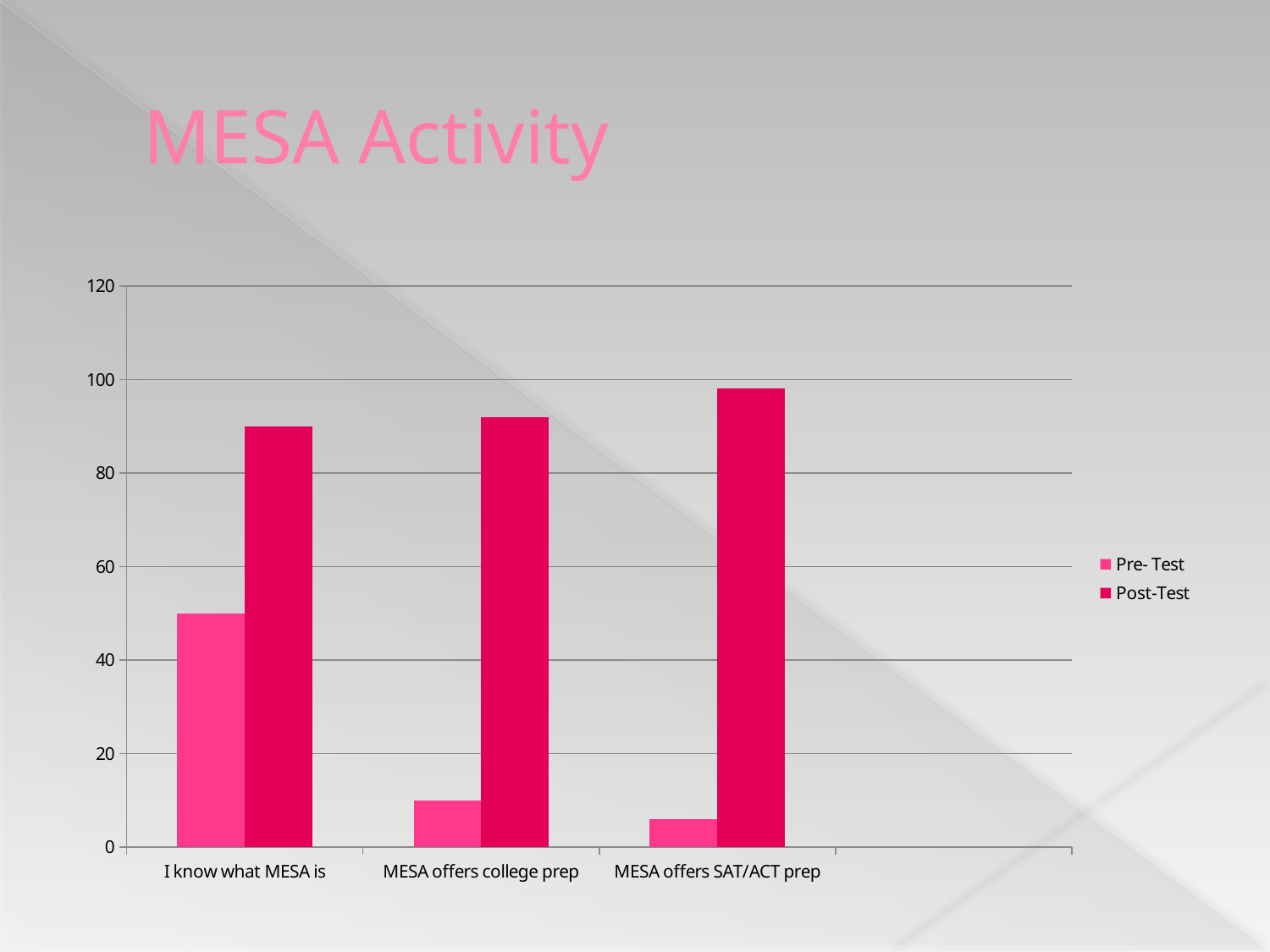
How many categories are shown on the x axis? 3 What is the title of the slide containing the chart? MESA Activity Which category has the highest Pre-Test value? I know what MESA is Is the Pre-Test value for 'MESA offers college prep' greater or less than 20? less What kind of chart is shown on the slide? bar chart Is the Pre-Test value for 'I know what MESA is' greater or less than 40? greater For 'MESA offers college prep', which is larger, the Pre-Test or the Post-Test value? Post-Test Is the Post-Test value for 'I know what MESA is' greater or less than 80? greater Which is larger, the Pre-Test value for 'I know what MESA is' or the Pre-Test value for 'MESA offers SAT/ACT prep'? I know what MESA is Which category has the highest Post-Test value? MESA offers SAT/ACT prep How many series does the legend list? 2